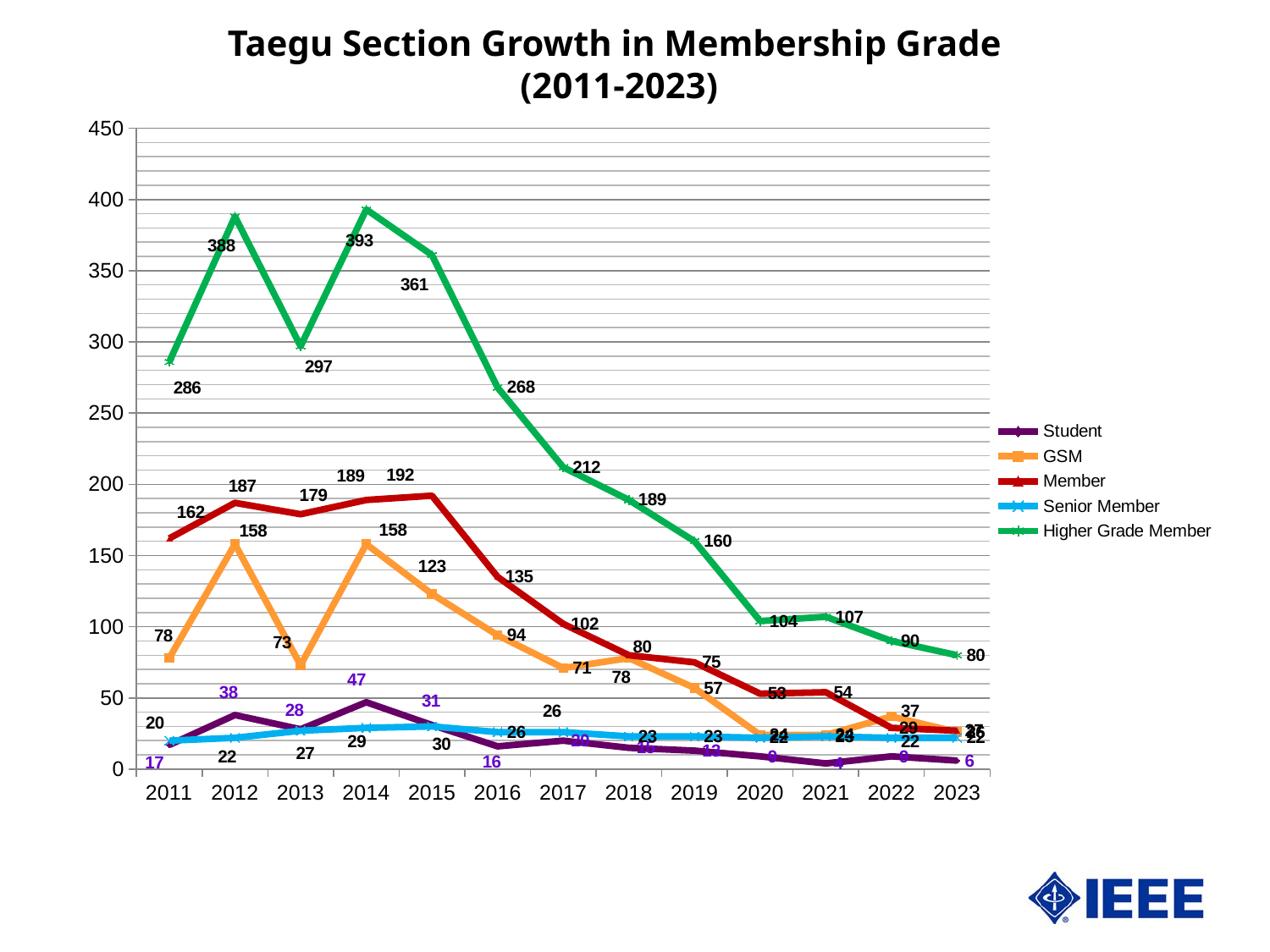
What is the difference between the Higher Grade Member values for 2012 and 2013? 91 What is the GSM value for 2012? 158 What type of chart is shown on the slide? line chart What is the Student value for 2014? 47 What is the Member value for 2015? 192 How many years are plotted along the x axis? 13 In which year is the Higher Grade Member value lowest? 2023 In which year does the Higher Grade Member series reach its highest value? 2014 Does the Higher Grade Member series rise or fall from 2015 to 2023? fall In 2015, which is larger: the Member value or the GSM value? Member How many series does the legend list? 5 What is the Higher Grade Member value for 2011? 286